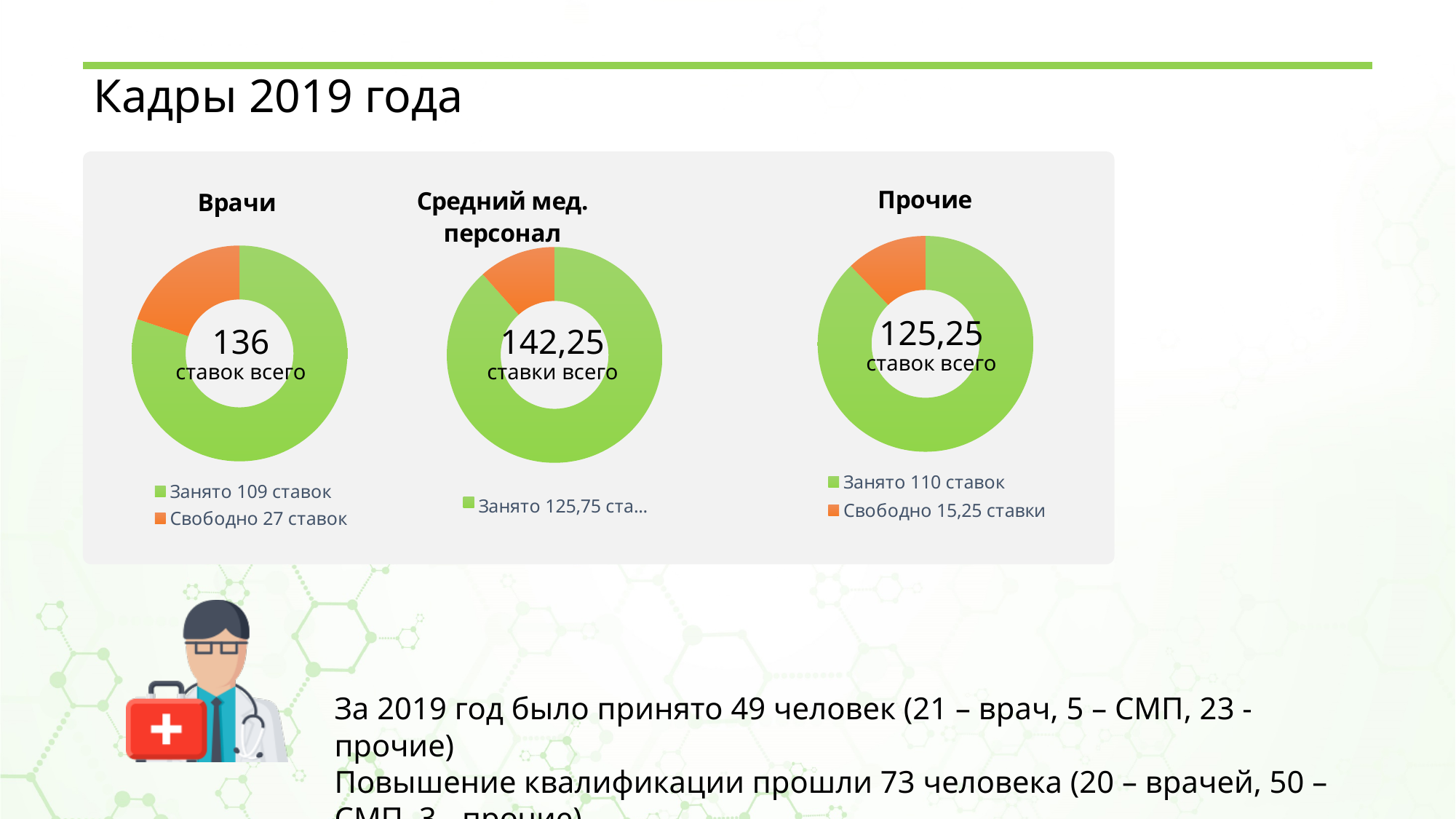
In the Средний мед. персонал chart, what value is given for Занято in the legend? 125,75 In the Врачи chart, what is the difference between the Занято and Свободно values? 82 What kind of chart is used for the Врачи data? doughnut chart In the Врачи chart, how many ставок are shown as Занято? 109 ставок What total number of ставок is shown in the centre of the Врачи chart? 136 In the Прочие chart, what value is shown for Свободно? 15,25 ставки Which of the three charts shows the largest total number of ставок in its centre? Средний мед. персонал What total is shown in the centre of the Средний мед. персонал chart? 142,25 How many entries does the legend of the Прочие chart list? 2 In the Врачи chart, which slice is larger, Занято or Свободно? Занято In the Прочие chart, how many ставок are shown as Занято? 110 ставок In the Врачи chart, how many ставок are shown as Свободно? 27 ставок